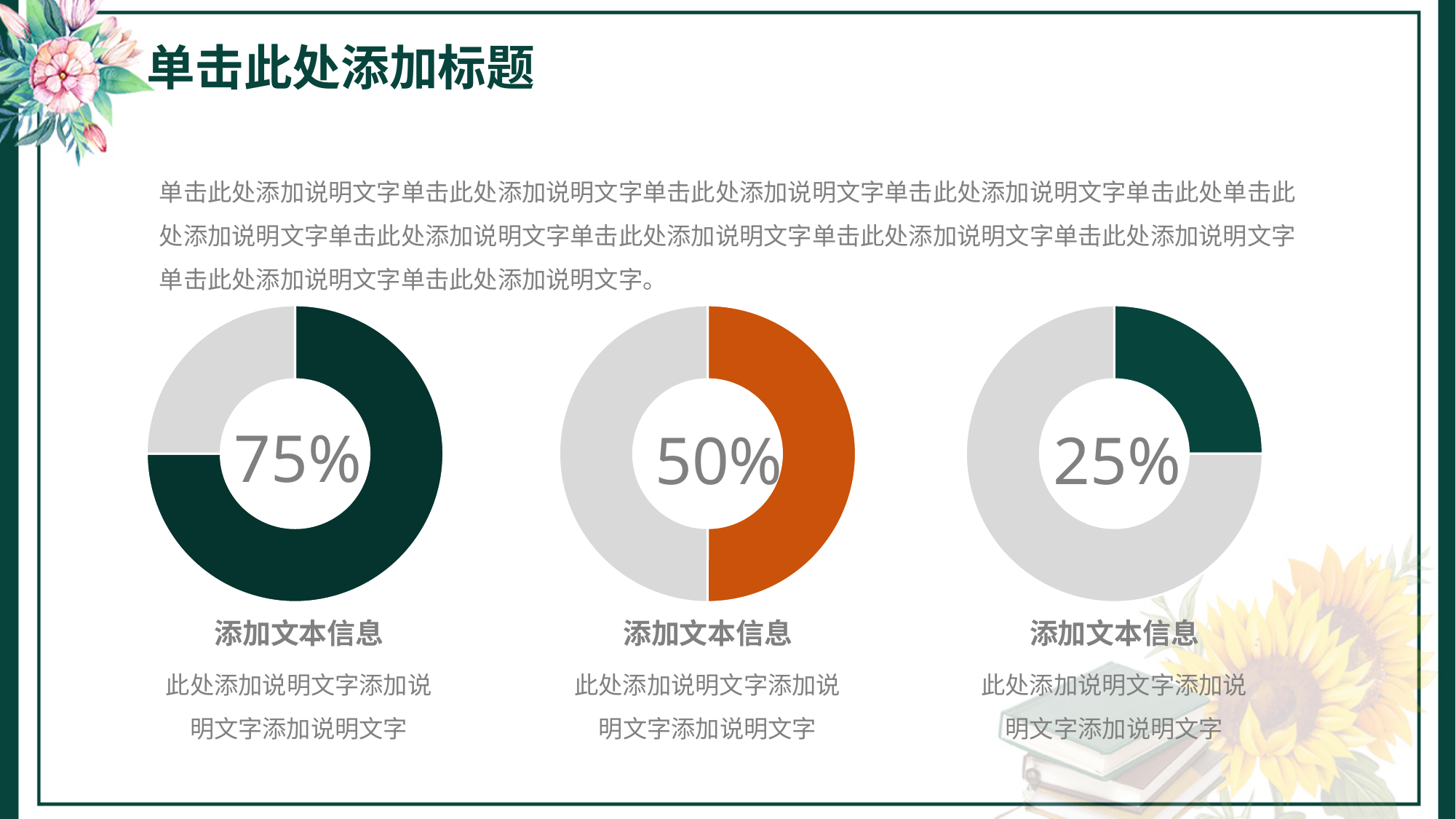
Do the percentages in the donut charts increase or decrease from left to right across the slide? Decrease Which of the three donut charts shows the highest percentage? The left one (75%) What value is shown in the centre of the right donut chart? 25% What value is shown in the centre of the left donut chart? 75% What colour is the filled portion of the middle donut chart? Orange What value is shown in the centre of the middle donut chart? 50% How many donut charts are on the slide? 3 What kind of chart is used to show the three percentages on the slide? Donut chart What is the difference between the percentage in the left donut chart and the percentage in the right donut chart? 50% Which is larger, the percentage in the middle donut chart or the percentage in the right donut chart? The middle donut chart (50%) Which of the three donut charts shows the lowest percentage? The right one (25%) What is the difference between the percentage in the left donut chart and the percentage in the middle donut chart? 25%